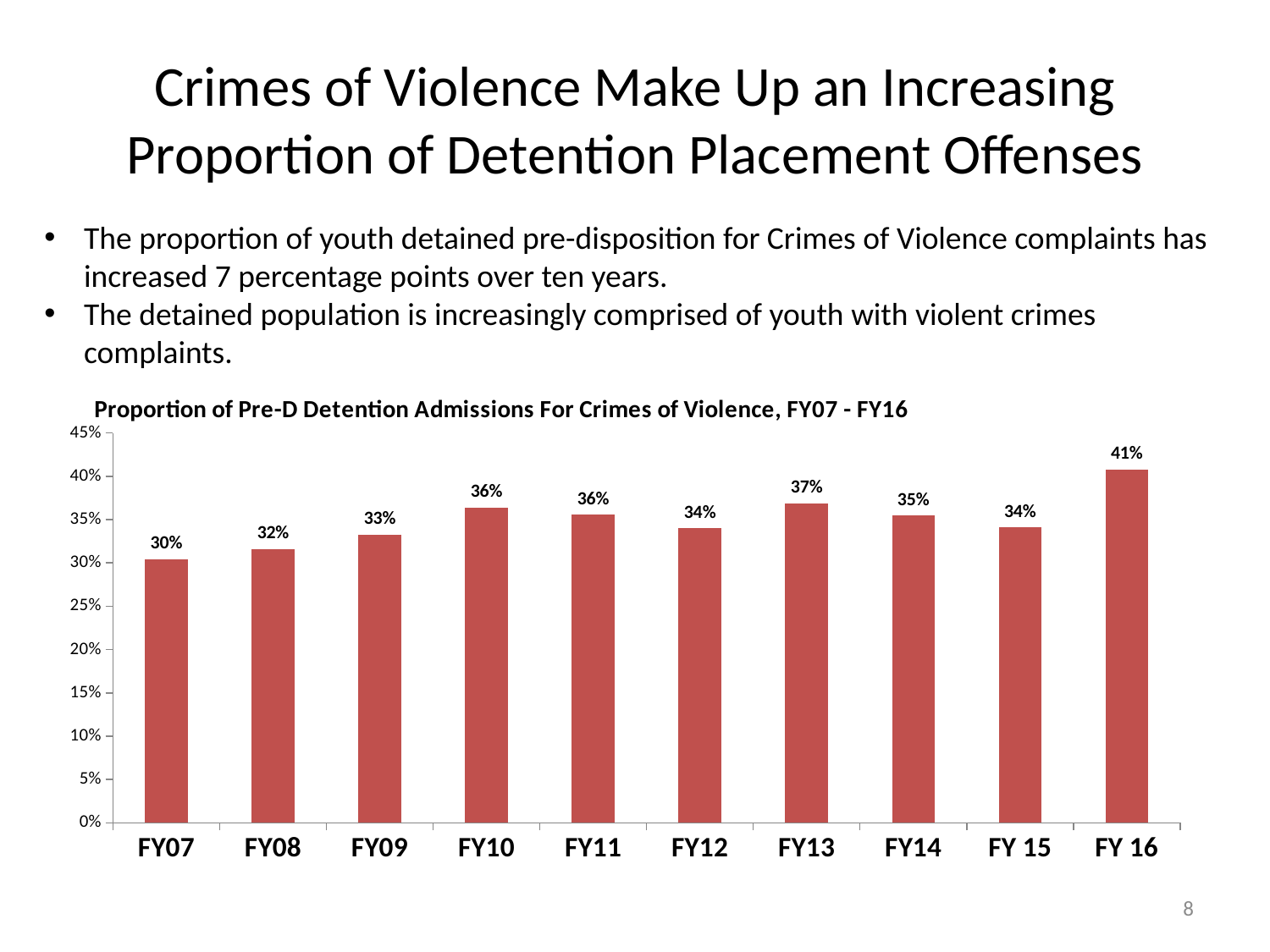
Which is larger, the value for FY10 or the value for FY12? FY10 What is the value for FY07? 30% Which fiscal year has the highest proportion? FY 16 Which fiscal year has the lowest proportion? FY07 How many fiscal years are shown on the chart? 10 What is the difference between the values for FY 16 and FY07? 11% What is the title of the chart? Proportion of Pre-D Detention Admissions For Crimes of Violence, FY07 - FY16 What kind of chart is shown on the slide? bar chart What is the value for FY 16? 41% What is the value for FY13? 37% Is the value for FY09 greater or less than 35%? less Do the values generally rise or fall from FY07 to FY 16? rise